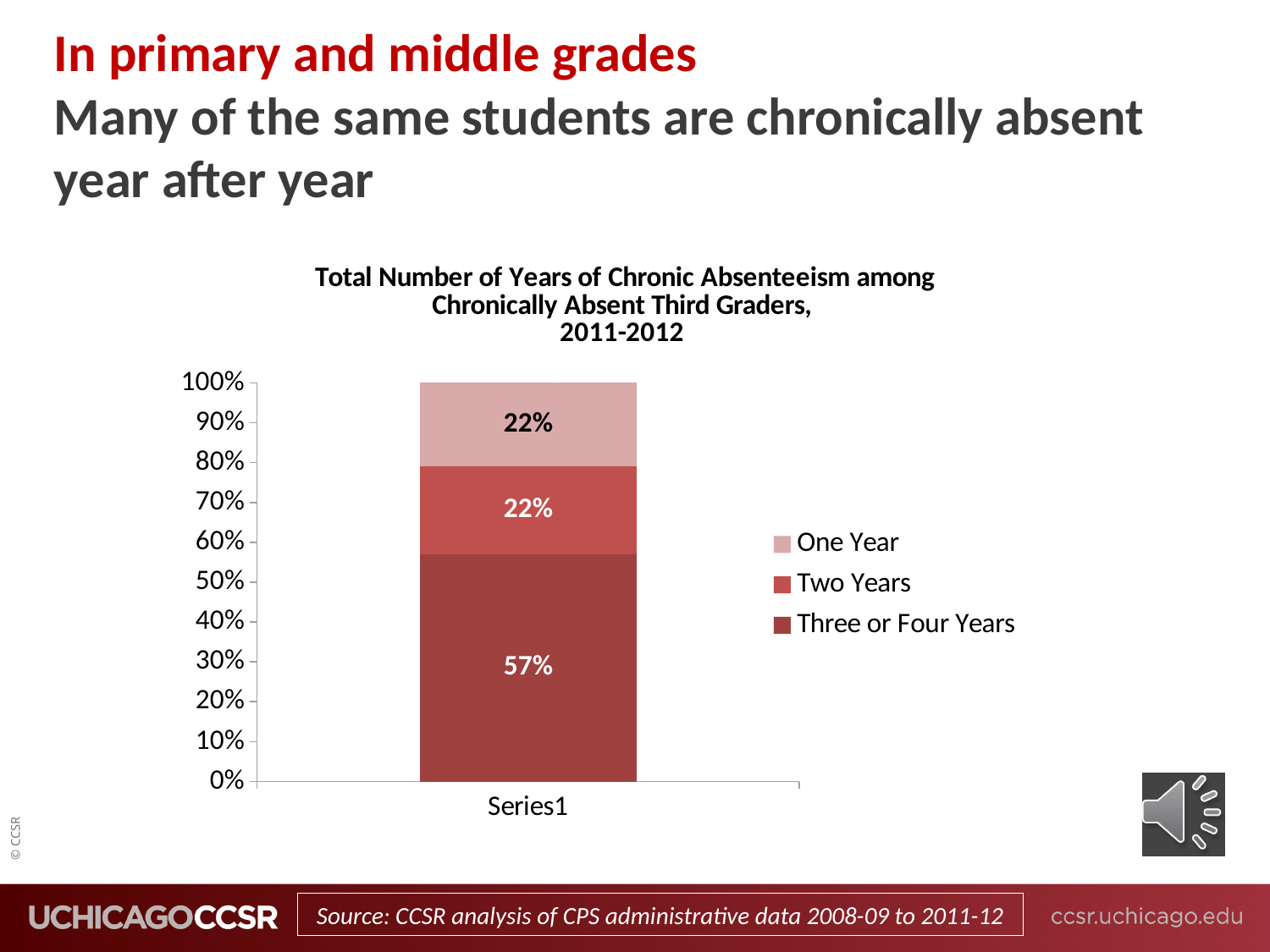
How many series does the legend list? 3 Which is larger, the Three or Four Years share or the Two Years share? Three or Four Years What percentage of chronically absent third graders were chronically absent for two years? 22% How many bars are plotted in the chart? 1 Is the value for Three or Four Years greater or less than 50%? greater What percentage of chronically absent third graders were chronically absent for three or four years? 57% What kind of chart is shown on the slide? Stacked bar chart What label appears on the x axis under the bar? Series1 What is the title of the chart? Total Number of Years of Chronic Absenteeism among Chronically Absent Third Graders, 2011-2012 What percentage of chronically absent third graders were chronically absent for one year? 22% Which legend category makes up the largest share of the stacked bar? Three or Four Years What is the difference between the Three or Four Years share and the One Year share? 35%